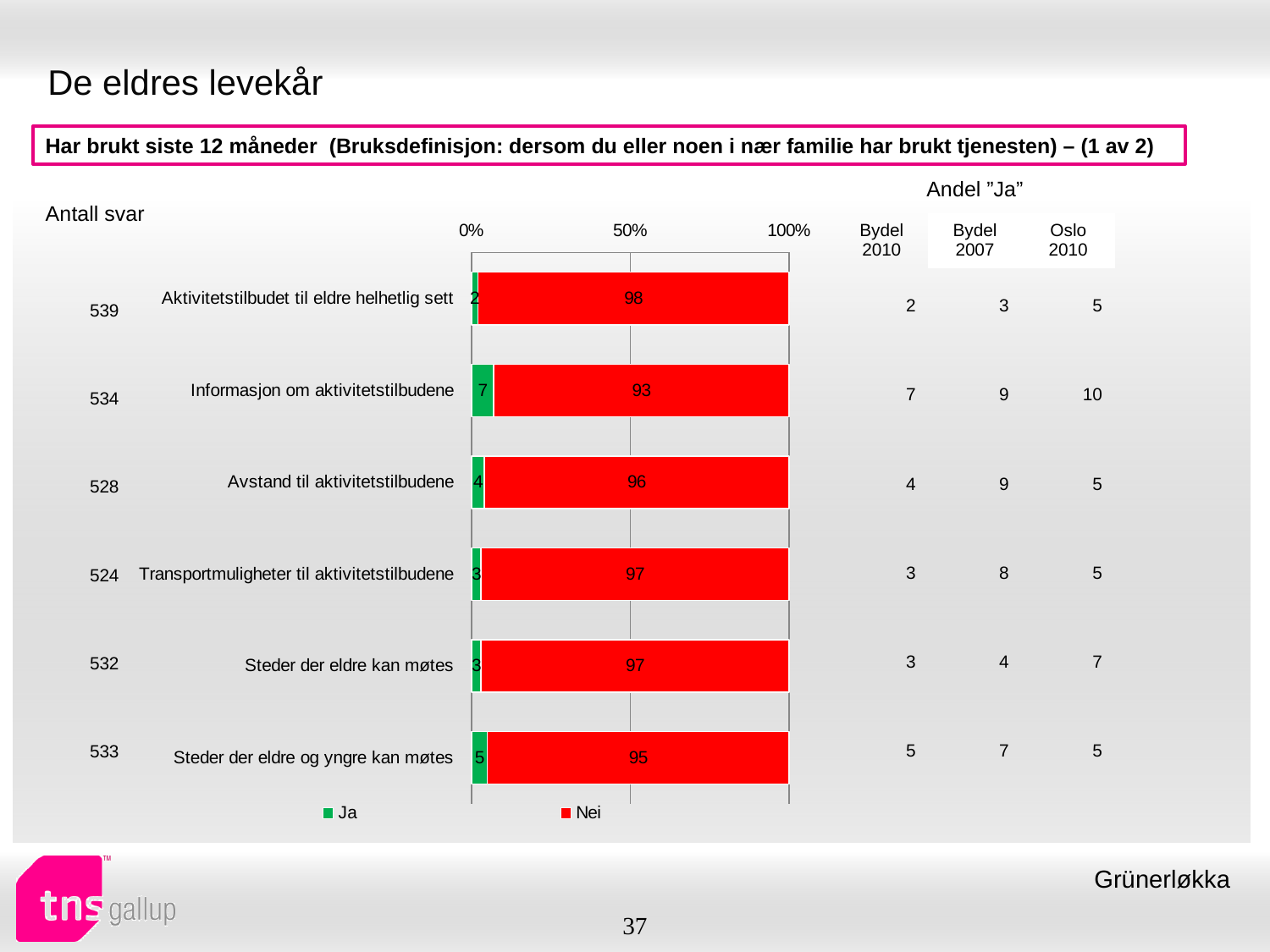
How many series does the legend list? 2 Which category has the highest "Ja" value? Informasjon om aktivitetstilbudene How many categories are shown in the chart? 6 What is the "Nei" value for "Aktivitetstilbudet til eldre helhetlig sett"? 98 Which is larger: the "Ja" value for "Avstand til aktivitetstilbudene" or the "Ja" value for "Steder der eldre og yngre kan møtes"? Steder der eldre og yngre kan møtes What kind of chart is shown on the slide? Stacked bar chart Which category has the lowest "Nei" value? Informasjon om aktivitetstilbudene What is the "Nei" value for "Informasjon om aktivitetstilbudene"? 93 What is the "Ja" value for "Steder der eldre og yngre kan møtes"? 5 What is the difference between the "Nei" values for "Aktivitetstilbudet til eldre helhetlig sett" and "Steder der eldre og yngre kan møtes"? 3 Which colour represents "Nei" in the chart? Red Is the "Nei" value for "Avstand til aktivitetstilbudene" greater or less than 50%? greater